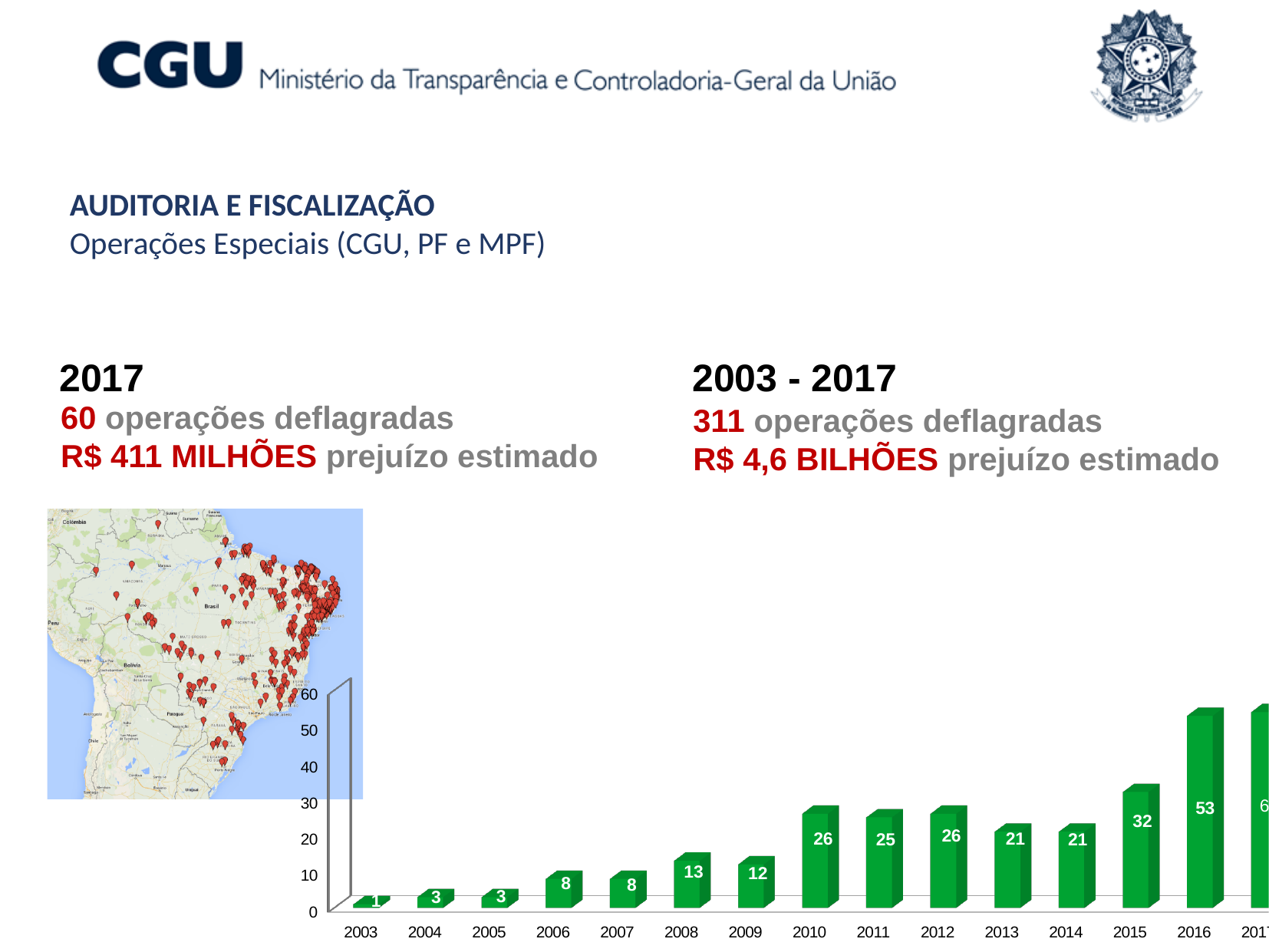
Which year has the lowest value in the bar chart? 2003 Is the value for 2016 in the bar chart greater or less than 50? greater What is the value for 2003 in the bar chart? 1 What is the value for 2013 in the bar chart? 21 What is the value for 2010 in the bar chart? 26 What is the difference between the values for 2010 and 2008 in the bar chart? 13 How many years are shown on the x axis of the bar chart? 15 What kind of chart is shown at the bottom of the slide? bar chart What is the difference between the values for 2016 and 2015 in the bar chart? 21 Do the values in the bar chart generally rise or fall from 2003 to 2017? rise What is the value for 2016 in the bar chart? 53 Which year has the larger value in the bar chart, 2008 or 2009? 2008